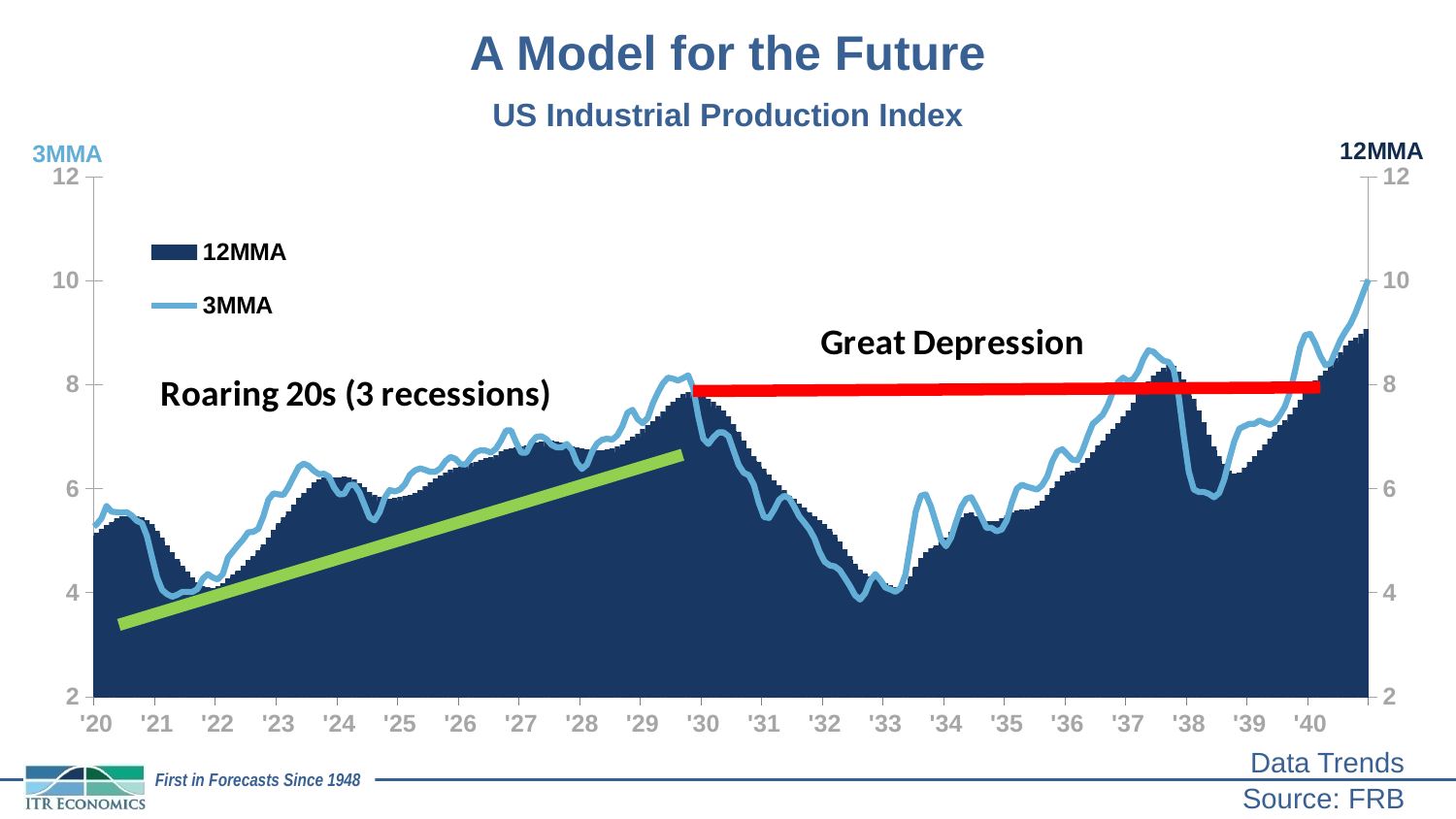
Is the value of the 12MMA series at the start of the chart ('20) greater or less than 6? less How many series does the legend list? 2 What is the subtitle naming the data plotted in the chart? US Industrial Production Index Which is higher, the 12MMA value at its peak around '37 or the 12MMA value at its low point around '33? the peak around '37 How many year labels are shown along the x axis? 21 What kind of chart is shown on the slide? area and line chart Is the value of the 3MMA series at the far right end of the chart (late '40) greater or less than 8? greater Is the value of the 3MMA series at its peak around '29 greater or less than 6? greater Does the 12MMA series rise or fall between '33 and '37? rise What are the two series named in the legend? 12MMA and 3MMA Does the 12MMA series rise or fall between '30 and '33? fall